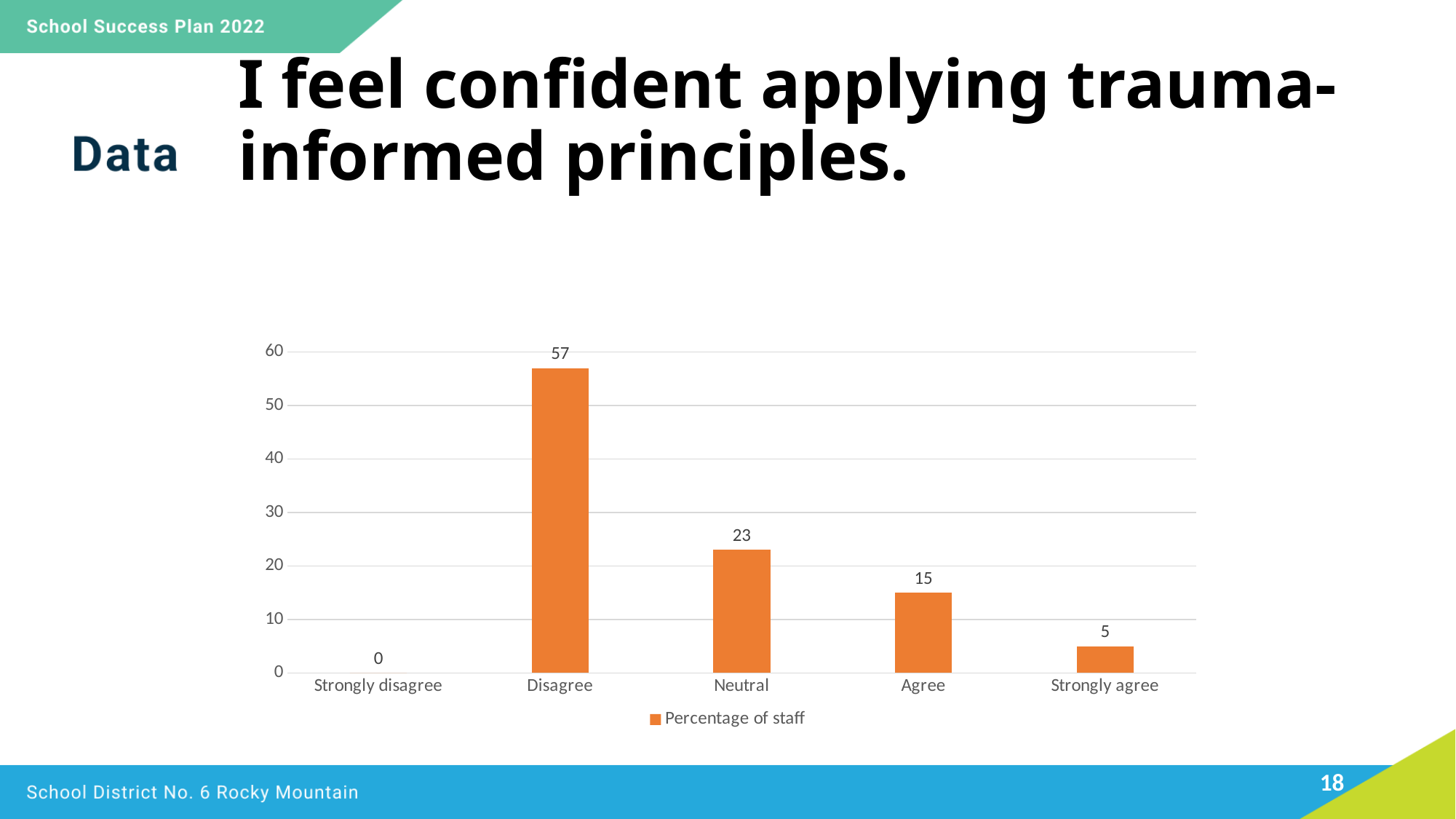
Which is larger, the value for Agree or the value for Strongly agree? Agree What is the value for Neutral? 23 Which category has the lowest value? Strongly disagree What is the value for Strongly disagree? 0 What is the value for Strongly agree? 5 What is the difference between the values for Disagree and Neutral? 34 What series name does the legend show? Percentage of staff What kind of chart is shown on the slide? Bar chart Which category has the highest value? Disagree What is the value for Agree? 15 How many categories are shown on the x axis? 5 What is the value for Disagree? 57